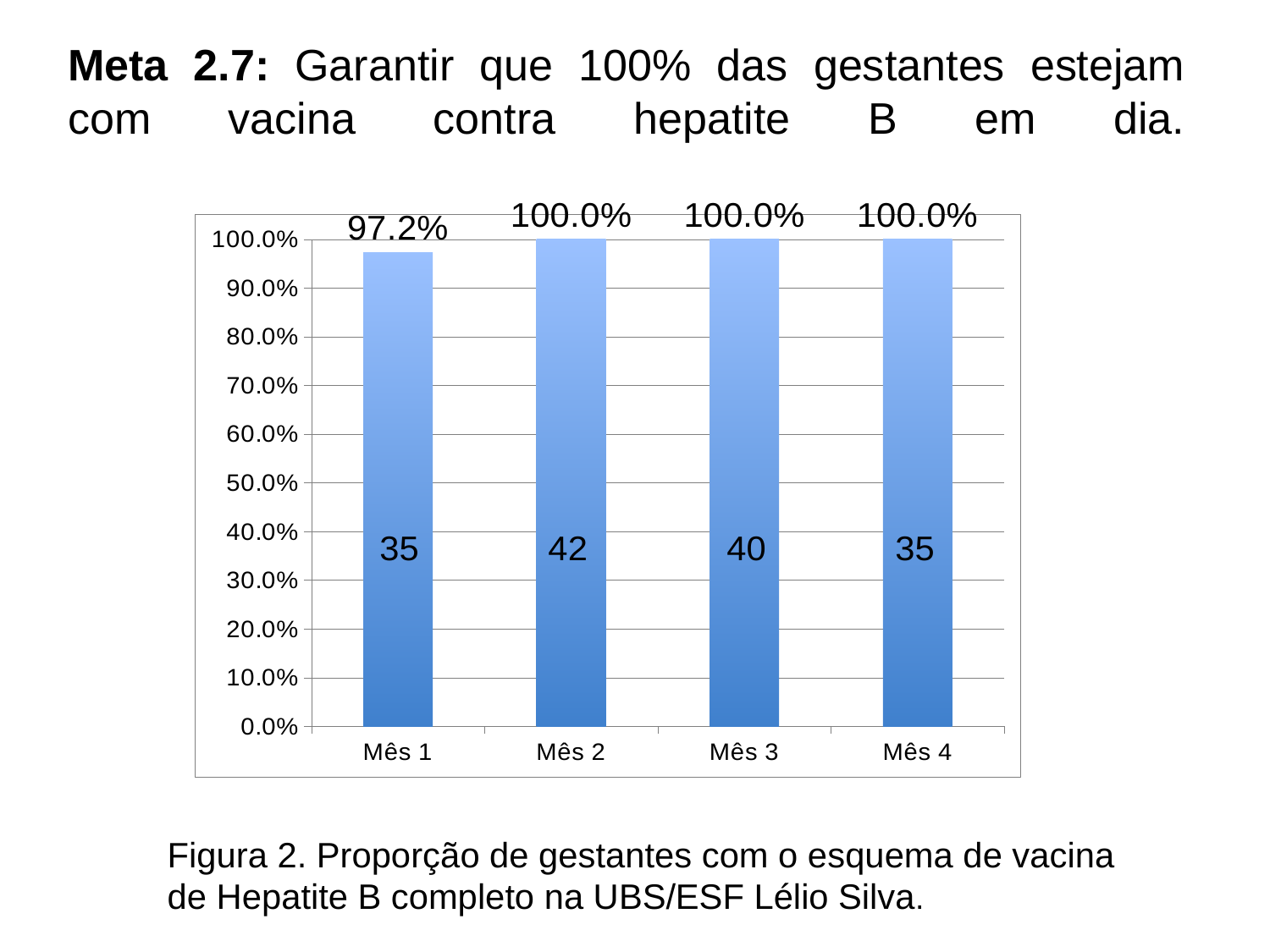
Which month has the highest number printed inside its bar? Mês 2 What number is printed inside the bar for Mês 4? 35 What percentage is shown for Mês 1? 97.2% What number is printed inside the bar for Mês 2? 42 Which is larger, the number inside the bar for Mês 3 or the number inside the bar for Mês 4? Mês 3 What kind of chart is shown on the slide? Bar chart Is the value for Mês 1 greater or less than 90.0%? greater What is the difference between the numbers printed inside the bars for Mês 2 and Mês 3? 2 Which month has the lowest percentage? Mês 1 What percentage is shown for Mês 3? 100.0% How many months are shown on the x axis? 4 What is the difference between the percentage for Mês 2 and the percentage for Mês 1? 2.8%